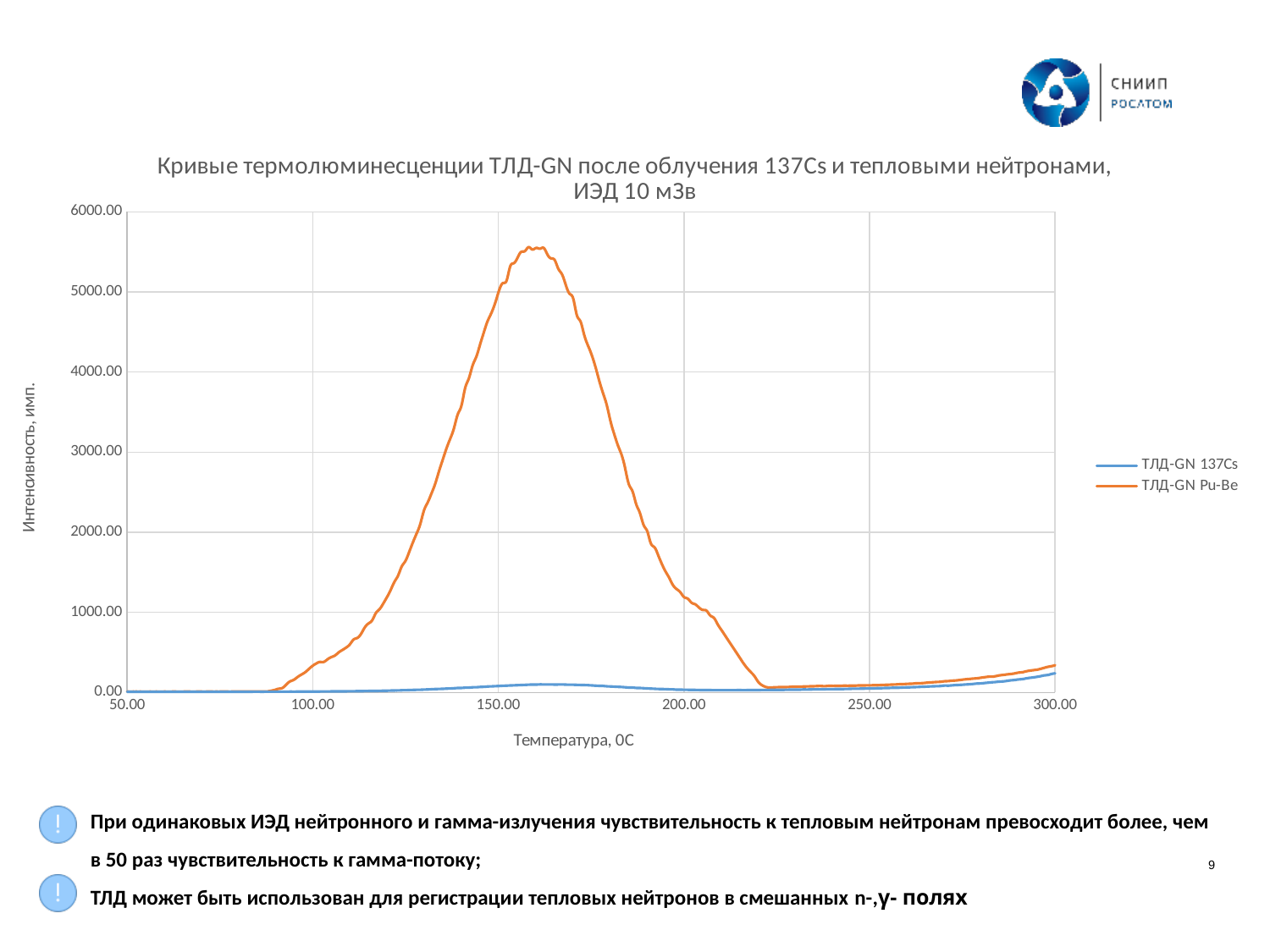
What is the label of the x axis? Температура, 0C Is the value of the ТЛД-GN 137Cs curve at 150.00 °C greater or less than 1000? less What are the two series named in the legend? ТЛД-GN 137Cs and ТЛД-GN Pu-Be What kind of chart is shown on the slide? line chart Is the peak value of the ТЛД-GN Pu-Be curve greater or less than 5000? greater Does the ТЛД-GN Pu-Be curve rise or fall between 170.00 °C and 220.00 °C? fall Which series reaches the higher peak intensity, ТЛД-GN 137Cs or ТЛД-GN Pu-Be? ТЛД-GN Pu-Be How many series does the legend list? 2 Is the value of the ТЛД-GN Pu-Be curve at 100.00 °C greater or less than 1000? less Does the ТЛД-GN Pu-Be curve rise or fall between 100.00 °C and 150.00 °C? rise At 160.00 °C, which series has the larger value, ТЛД-GN 137Cs or ТЛД-GN Pu-Be? ТЛД-GN Pu-Be